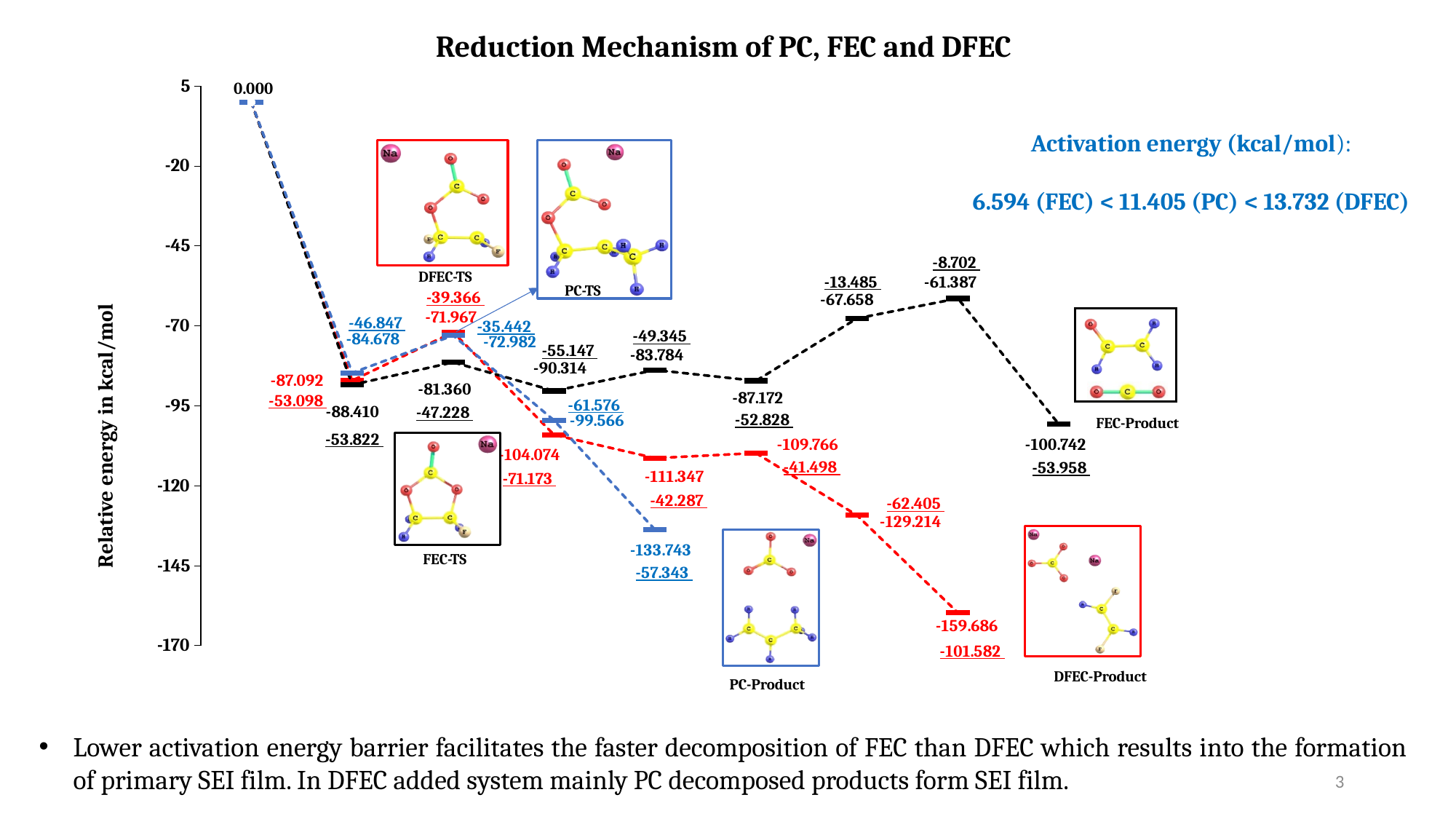
What is the relative energy value labelled at the starting point of the profile? 0.000 What activation energy (kcal/mol) is given for FEC? 6.594 Which of PC, FEC and DFEC has the highest activation energy? DFEC What is the lowest tick value shown on the y axis? -170 Which of PC, FEC and DFEC has the lowest activation energy? FEC What is the difference between the activation energies of DFEC and FEC? 7.138 What relative energy value is labelled at the end of the blue dashed PC pathway (PC-Product)? -133.743 What is the lowest relative energy value labelled on the chart (the red DFEC-Product level)? -159.686 What activation energy (kcal/mol) is given for DFEC? 13.732 What is the label of the y axis? Relative energy in kcal/mol What is the title of the chart? Reduction Mechanism of PC, FEC and DFEC What activation energy (kcal/mol) is given for PC? 11.405